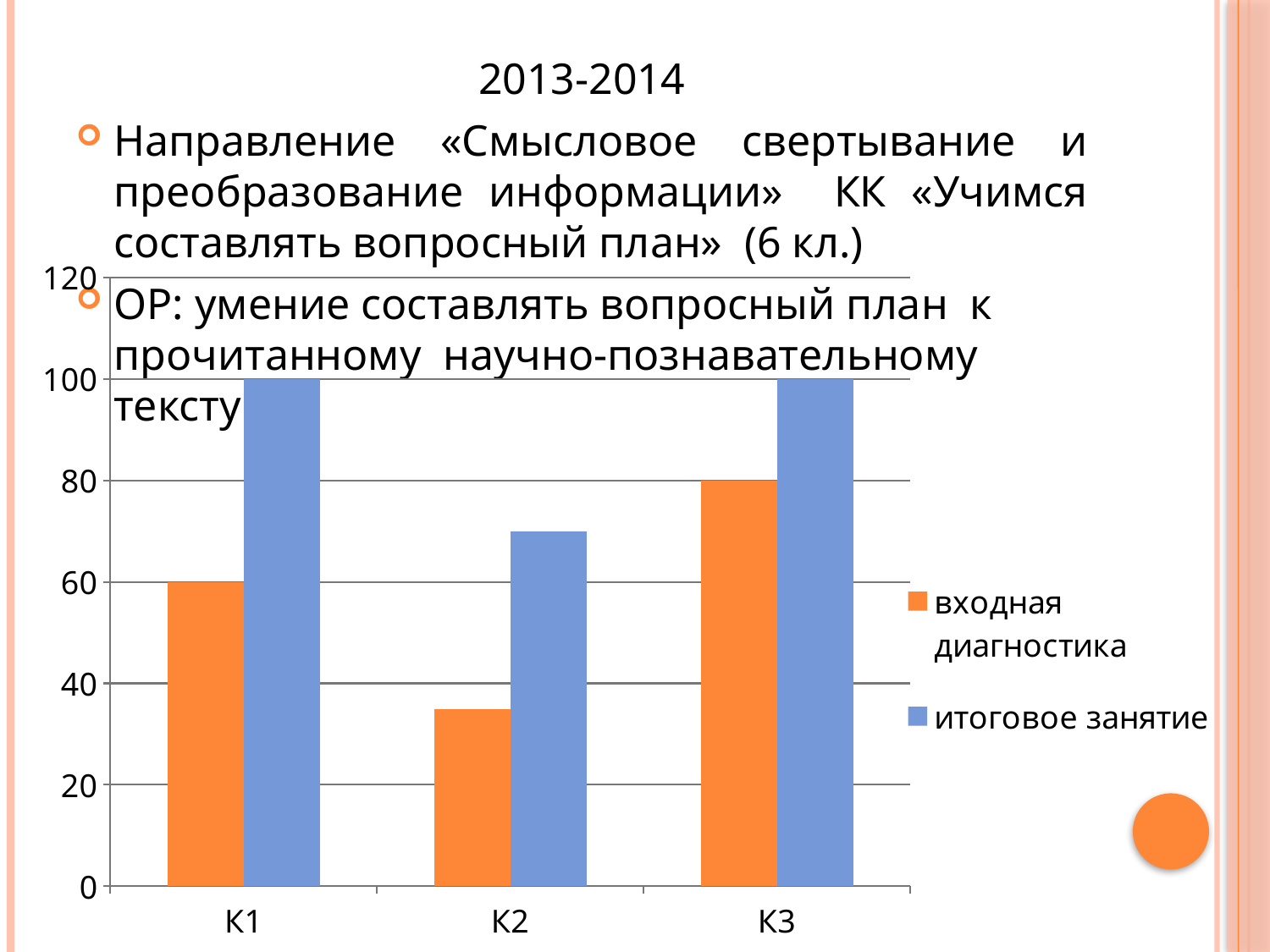
Which category has the highest value for входная диагностика? К3 What is the difference between итоговое занятие and входная диагностика for К1? 40 Which category has the lowest value for итоговое занятие? К2 What is the value of итоговое занятие for К1? 100 Is the value of итоговое занятие for К2 greater or less than 60? greater What type of chart is shown on the slide? bar chart What is the value of входная диагностика for К1? 60 What is the value of итоговое занятие for К3? 100 Is the value of входная диагностика for К2 greater or less than 40? less How many categories are shown on the x axis of the chart? 3 What is the value of входная диагностика for К3? 80 How many series does the chart legend list? 2